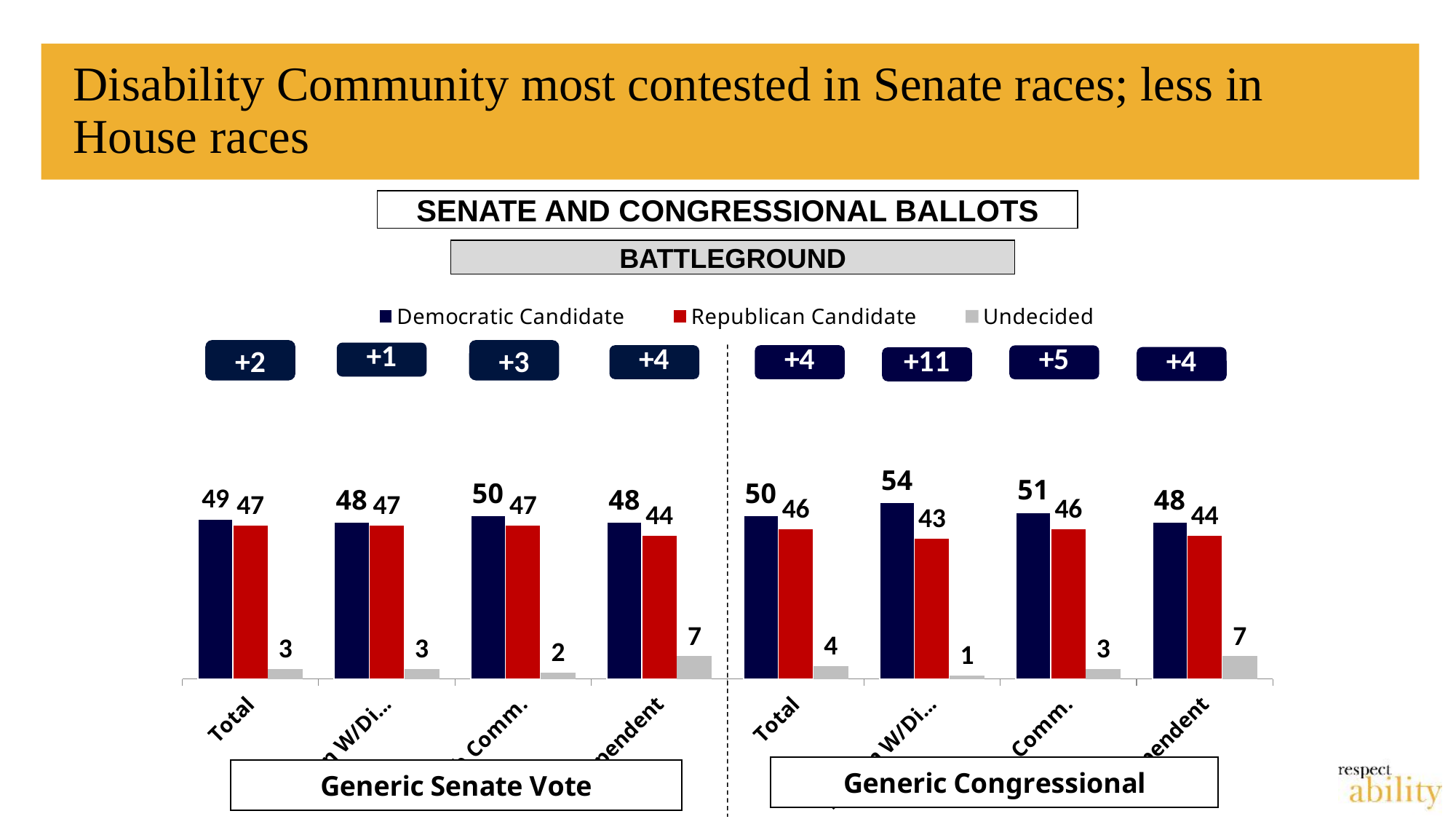
In the Generic Congressional chart, what is the Undecided value in the Total category? 4 In the Generic Senate Vote chart, which category has the highest Undecided value? The fourth category (7) What kind of chart is shown on the slide? Bar chart What colour represents the Republican Candidate in the legend? Red In the Generic Senate Vote chart, what is the value for the Republican Candidate in the Total category? 47 In the Generic Senate Vote chart, what is the difference between the Democratic Candidate and Republican Candidate values in the Total category? 2 How many series does the legend list? 3 In the Generic Congressional chart, which category has the highest Democratic Candidate value? The second category (54) In the Generic Congressional chart, is the Democratic Candidate value or the Republican Candidate value larger in the Total category? Democratic Candidate In the Generic Congressional chart, what is the value for the Democratic Candidate in the Total category? 50 In the Generic Senate Vote chart, what is the value for the Democratic Candidate in the Total category? 49 In the Generic Congressional chart, which category has the lowest Undecided value? The second category (1)